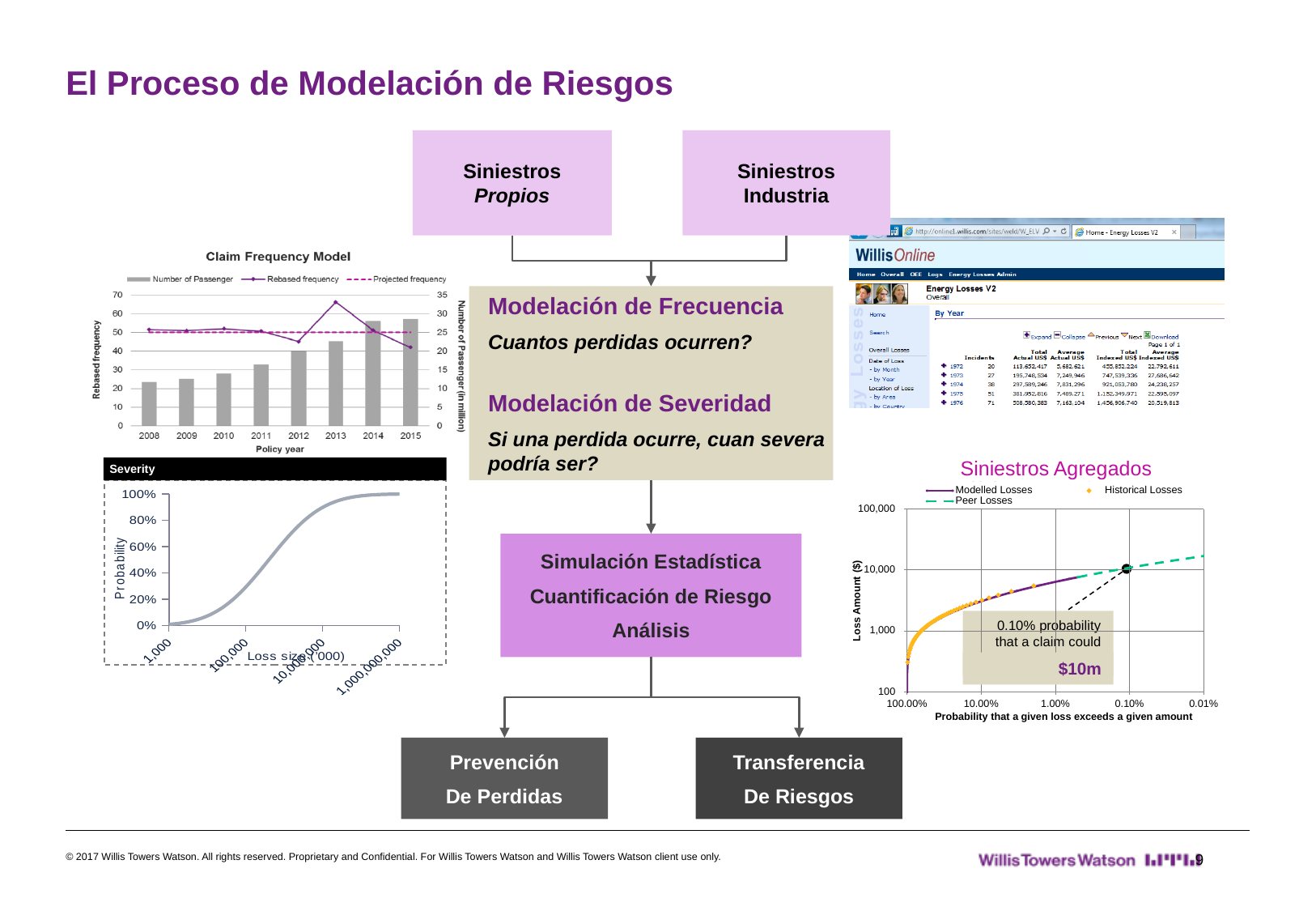
In the Claim Frequency Model chart, how many policy years are shown on the x axis? 8 In the Severity chart, does the probability rise or fall as loss size increases along the x axis? rise In the Claim Frequency Model chart, which is larger, the Number of Passenger bar for 2012 or for 2009? 2012 What kind of chart is the Severity chart? line chart In the Claim Frequency Model chart, is the Rebased frequency for 2013 greater or less than 30? greater In the Siniestros Agregados chart, how many series does the legend list? 3 What is the x-axis title of the Siniestros Agregados chart? Probability that a given loss exceeds a given amount In the Claim Frequency Model chart, in which policy year does the Rebased frequency line reach its highest point? 2013 In the Claim Frequency Model chart, how many series does the legend list? 3 In the Siniestros Agregados chart, what loss amount does the annotation say a claim could exceed with 0.10% probability? $10m In the Claim Frequency Model chart, do the Number of Passenger bars generally rise or fall from 2008 to 2015? rise In the Claim Frequency Model chart, which policy year has the lowest Number of Passenger bar? 2008